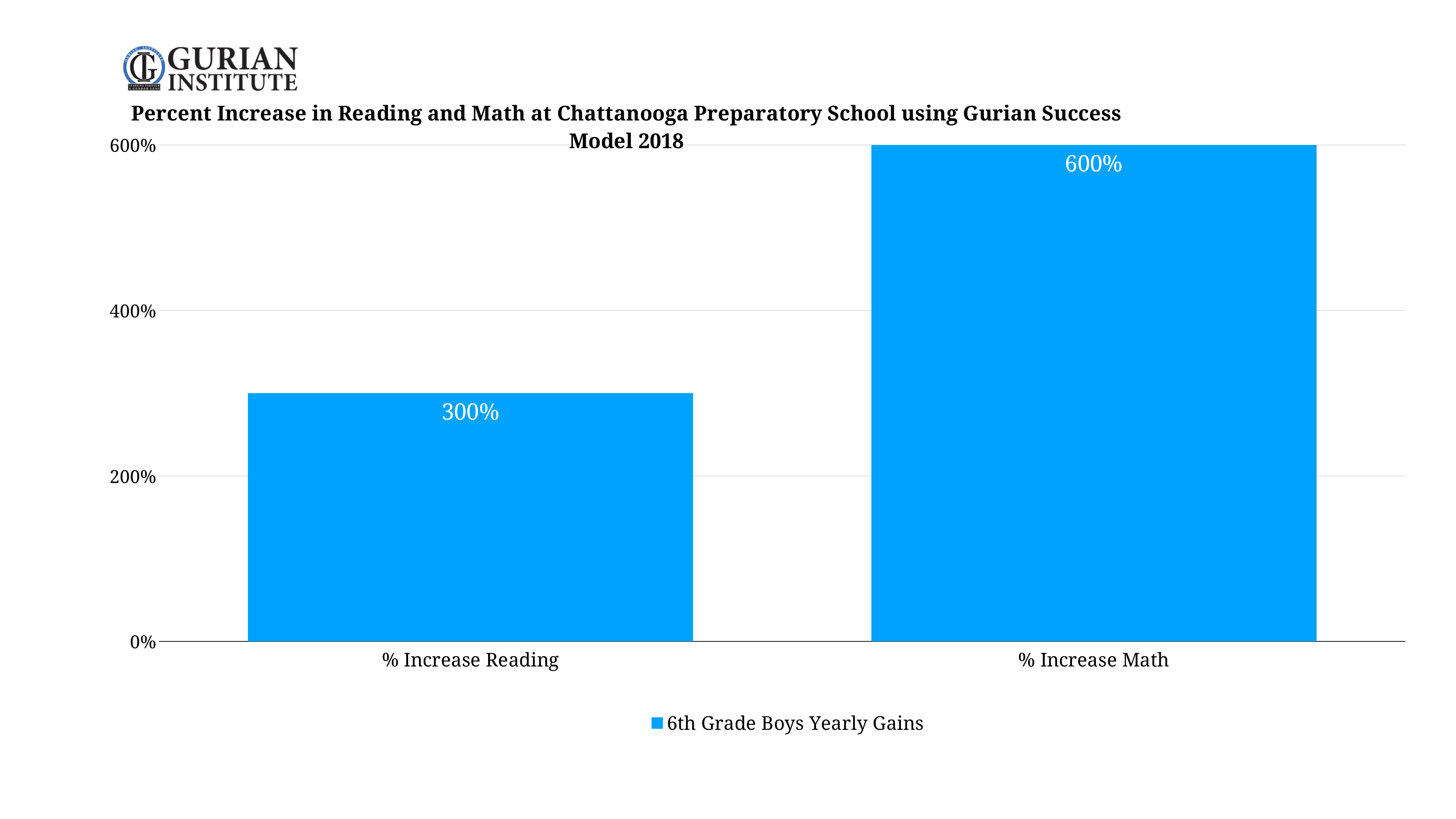
Which is larger, the value for % Increase Reading or the value for % Increase Math? % Increase Math Is the value for % Increase Reading greater or less than 400%? less Which category has the highest value? % Increase Math What is the difference between the value for % Increase Math and the value for % Increase Reading? 300% How many categories are shown on the x axis? 2 What kind of chart is shown on the slide? bar chart What series name is shown in the legend? 6th Grade Boys Yearly Gains What is the value for % Increase Reading? 300% Is the value for % Increase Math greater or less than 400%? greater Which category has the lowest value? % Increase Reading How many series does the legend list? 1 What is the value for % Increase Math? 600%